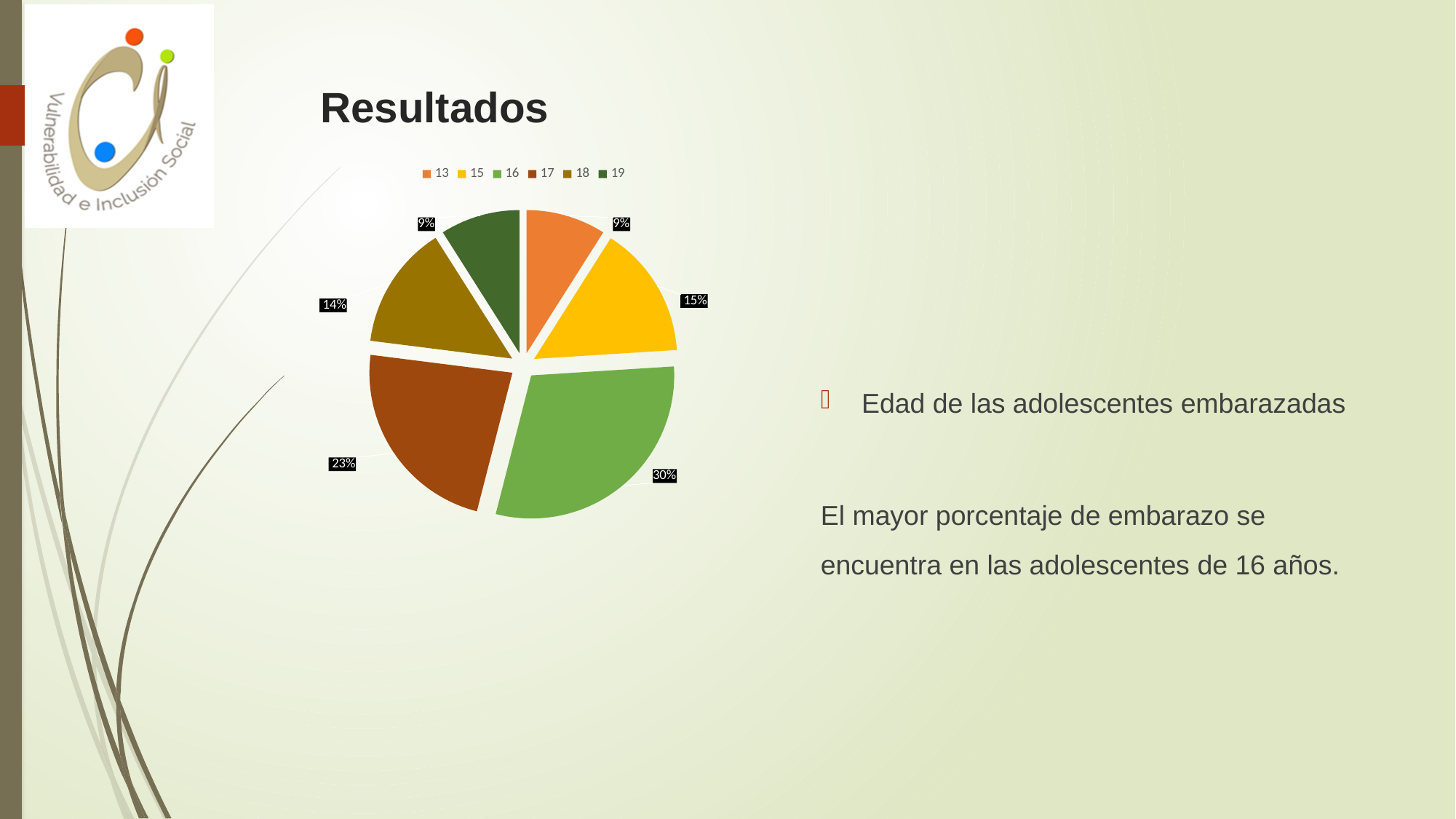
What percentage of the pie chart corresponds to age 15? 15% Which age has the largest slice in the pie chart? 16 How many slices does the pie chart have? 6 Which slice is larger in the pie chart, age 17 or age 18? 17 How many entries does the legend of the pie chart list? 6 What percentage of the pie chart corresponds to age 13? 9% What is the difference in percentage points between the slices for age 16 and age 17? 7 What percentage of the pie chart corresponds to age 18? 14% What kind of chart is shown on the slide? pie chart Which ages are listed in the legend of the pie chart? 13, 15, 16, 17, 18, 19